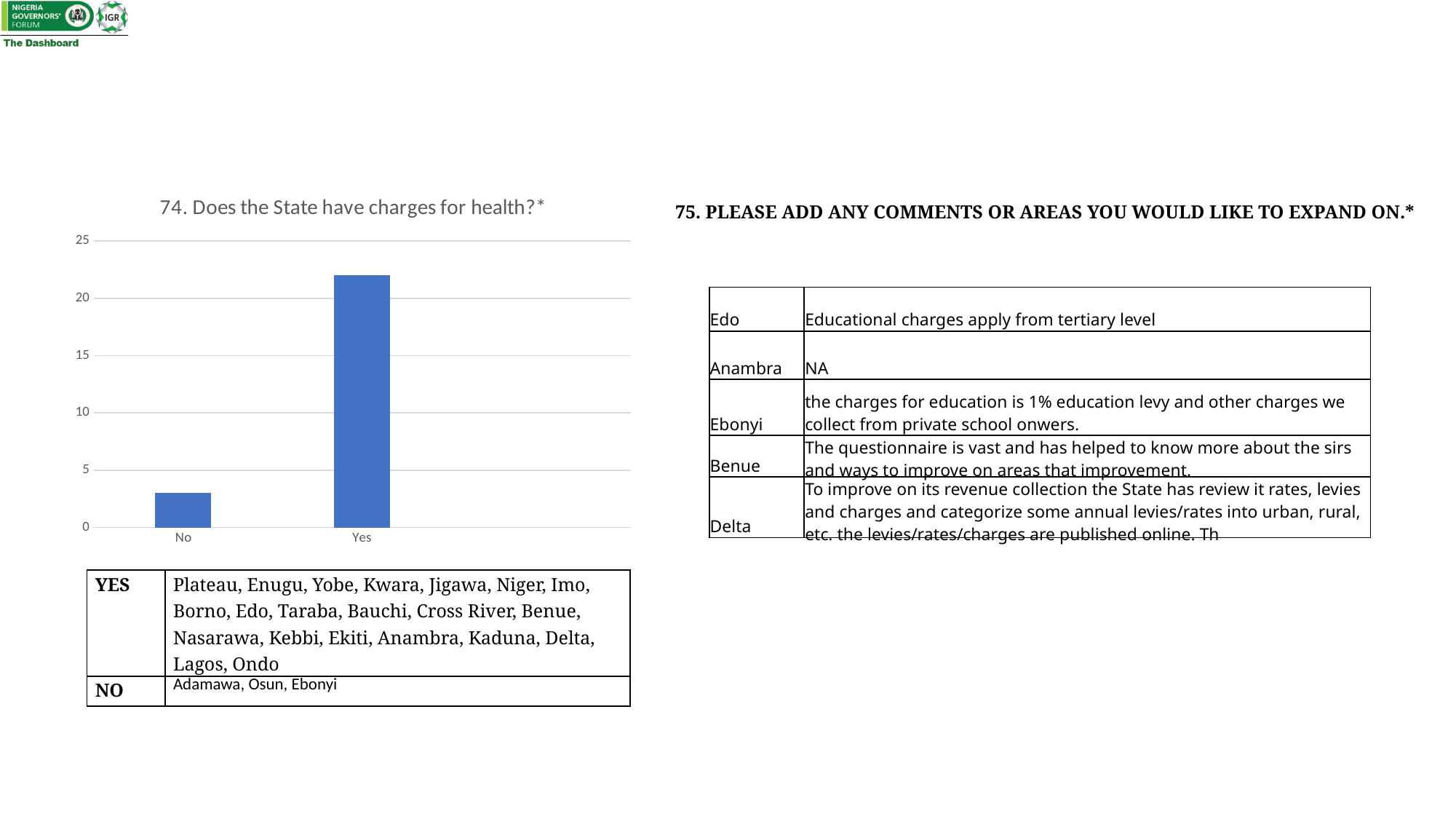
Is the value for Yes greater or less than 25? less Which category has the highest bar in the chart? Yes What kind of chart is shown on the slide? bar chart Is the value for Yes greater or less than 20? greater Is the value for No greater or less than 10? less Which category has the lowest bar in the chart? No What is the highest value shown on the y axis of the chart? 25 How many categories are shown on the x axis of the chart? 2 Is the bar for Yes taller than the bar for No? Yes What is the title of the chart? 74. Does the State have charges for health?*